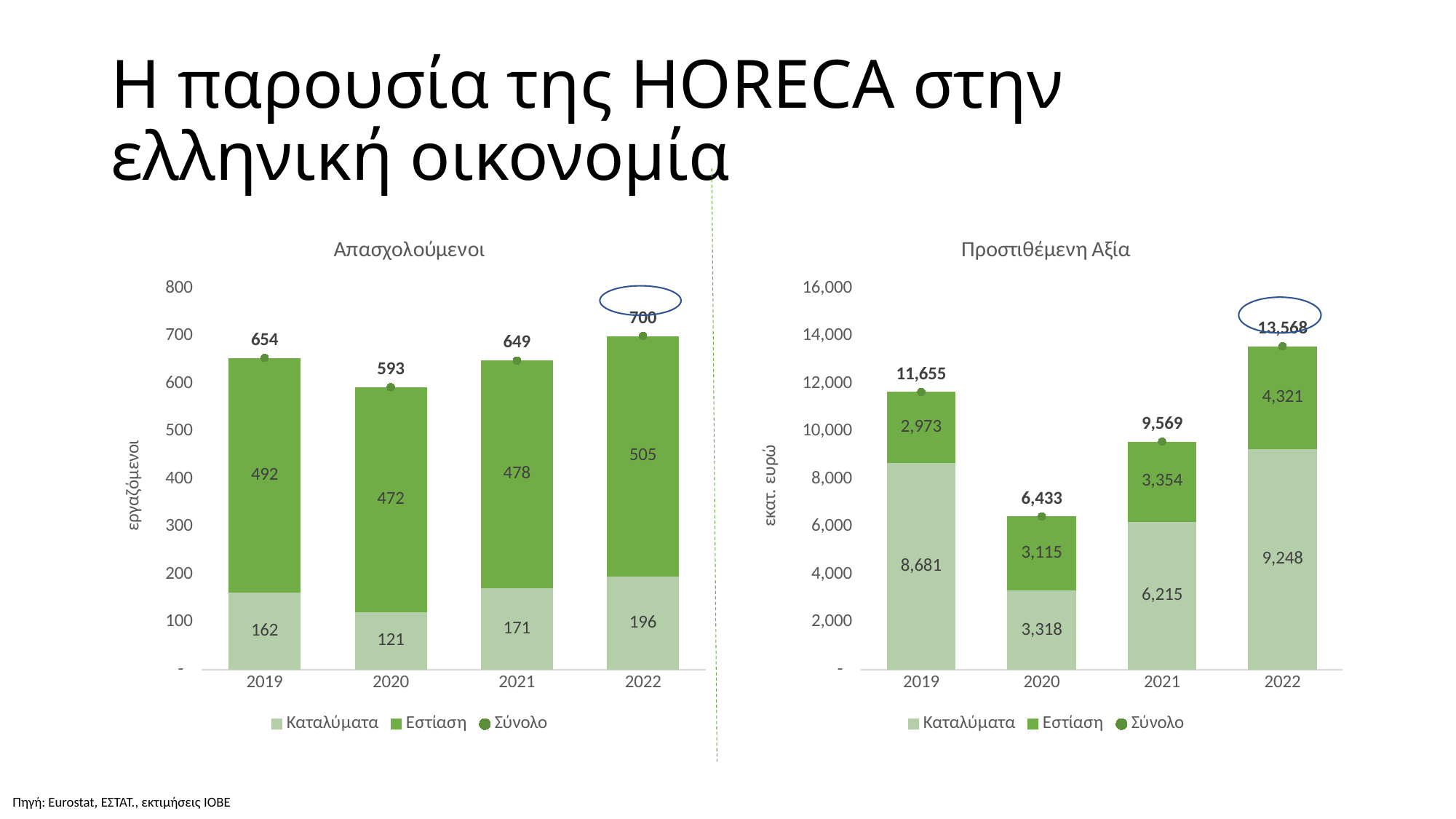
In the Προστιθέμενη Αξία chart, is the value for Καταλύματα larger in 2020 or in 2021? 2021 In the Προστιθέμενη Αξία chart, which year has the highest Σύνολο? 2022 In the Απασχολούμενοι chart, which year has the lowest Σύνολο? 2020 In the Προστιθέμενη Αξία chart, what is the value for Καταλύματα in 2019? 8,681 How many years are shown on the x axis of the Απασχολούμενοι chart? 4 In the Απασχολούμενοι chart, what is the value for Εστίαση in 2022? 505 In the Προστιθέμενη Αξία chart, what is the value for Εστίαση in 2021? 3,354 In the Απασχολούμενοι chart, what is the value for Καταλύματα in 2020? 121 In the Προστιθέμενη Αξία chart, what is the difference between Καταλύματα and Εστίαση in 2022? 4,927 In the Απασχολούμενοι chart, what is the difference between the Σύνολο for 2022 and 2019? 46 What kind of chart is the Προστιθέμενη Αξία chart? Stacked bar chart In the Απασχολούμενοι chart, what is the total of the stacked bar for 2021? 649